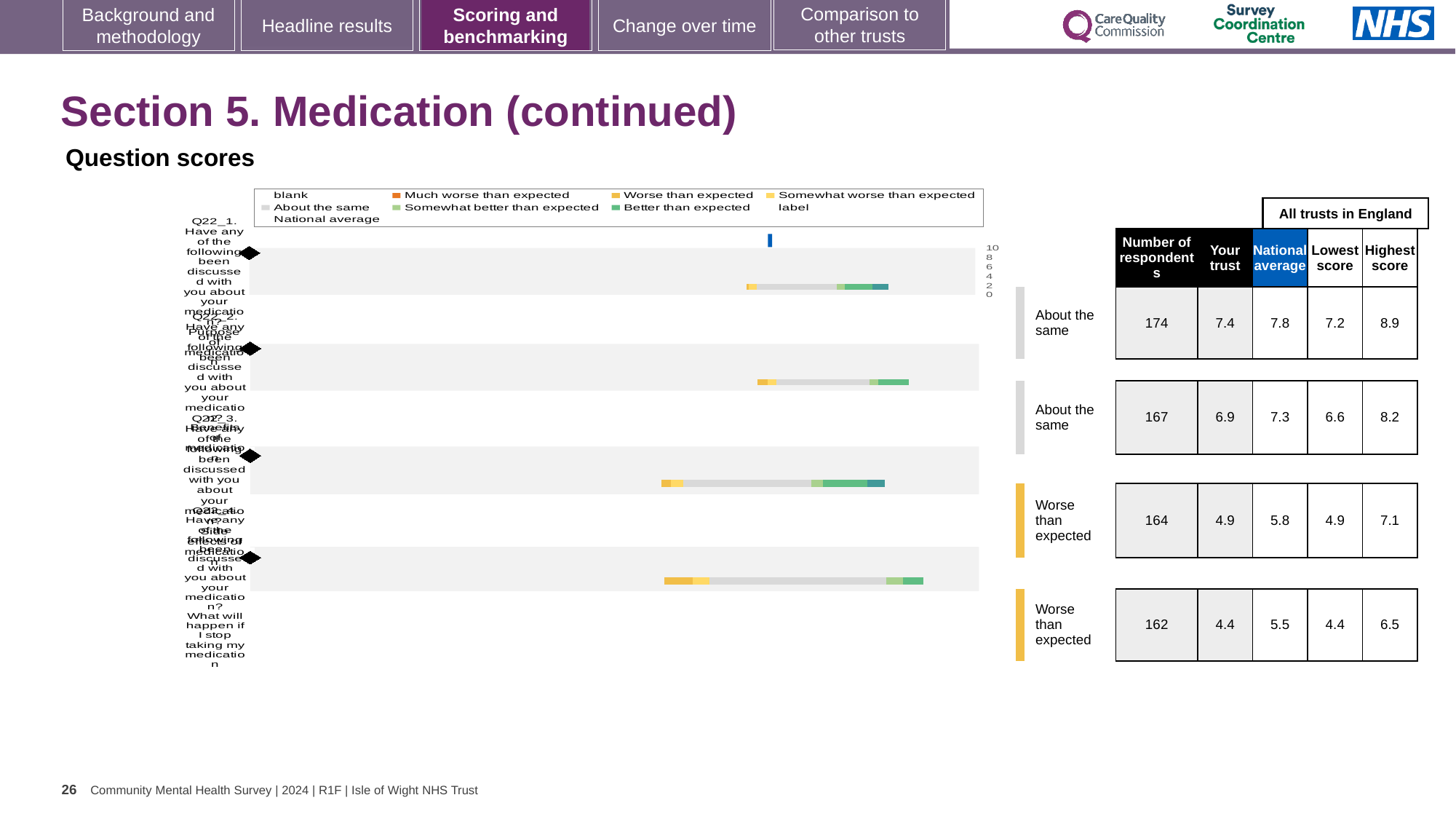
What benchmark category is shown for the third row (Q22_3)? Worse than expected In the table beside the chart, what is the highest score for the fourth row (Q22_4)? 6.5 Which row has the lowest number of respondents in the table beside the chart? The fourth row (Q22_4), 162 How many question rows (bars) does the chart show? 4 For the first row (Q22_1), which is larger: the 'Your trust' score or the national average? National average In the table beside the chart, what is the 'Your trust' score for the first row (Q22_1)? 7.4 What kind of chart is shown under 'Question scores'? bar chart In the table beside the chart, what is the national average for the first row (Q22_1)? 7.8 For the first row (Q22_1), what is the difference between the national average and the 'Your trust' score? 0.4 In the chart legend, what colour represents 'Worse than expected'? yellow-orange In the chart legend, what colour represents 'Better than expected'? teal green In the table beside the chart, how many respondents are listed for the first row (Q22_1)? 174